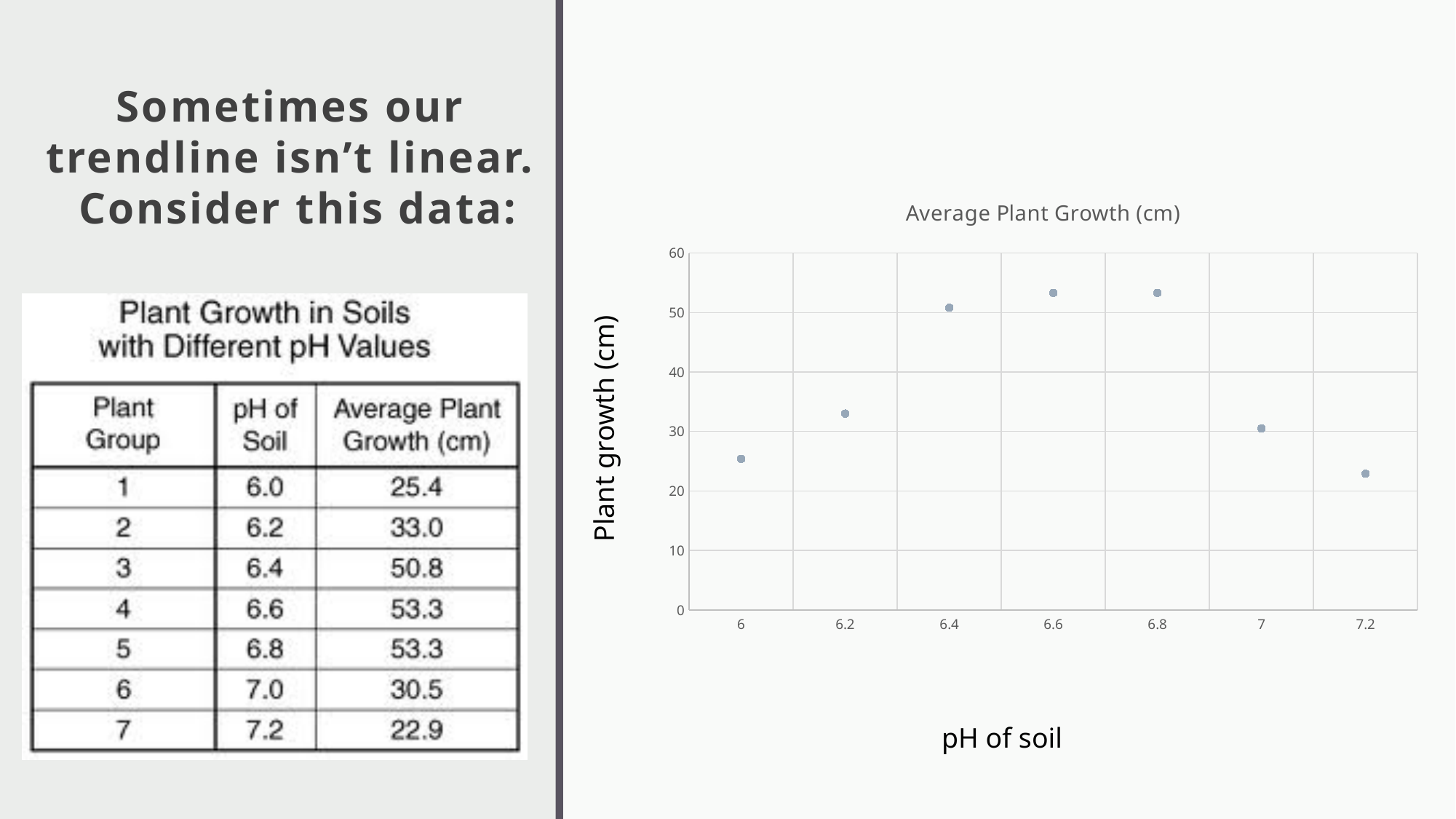
What is the difference between the average plant growth at pH 6.6 and at pH 6.0? 27.9 What is the average plant growth at pH 7.0? 30.5 What is the average plant growth at pH 6.0? 25.4 What is the title of the chart? Average Plant Growth (cm) At which pH value is the average plant growth lowest? 7.2 Which has the larger plant growth value, pH 6.2 or pH 6.4? pH 6.4 What is the label of the chart's x axis? pH of soil How many data points are plotted in the chart? 7 What kind of chart is shown on the right side of the slide? scatter chart Is the plant growth value at pH 7.2 greater or less than 30? less Do the plant growth values rise or fall as pH increases from 6.8 to 7.2? fall Is the plant growth value at pH 6.4 greater or less than 40? greater